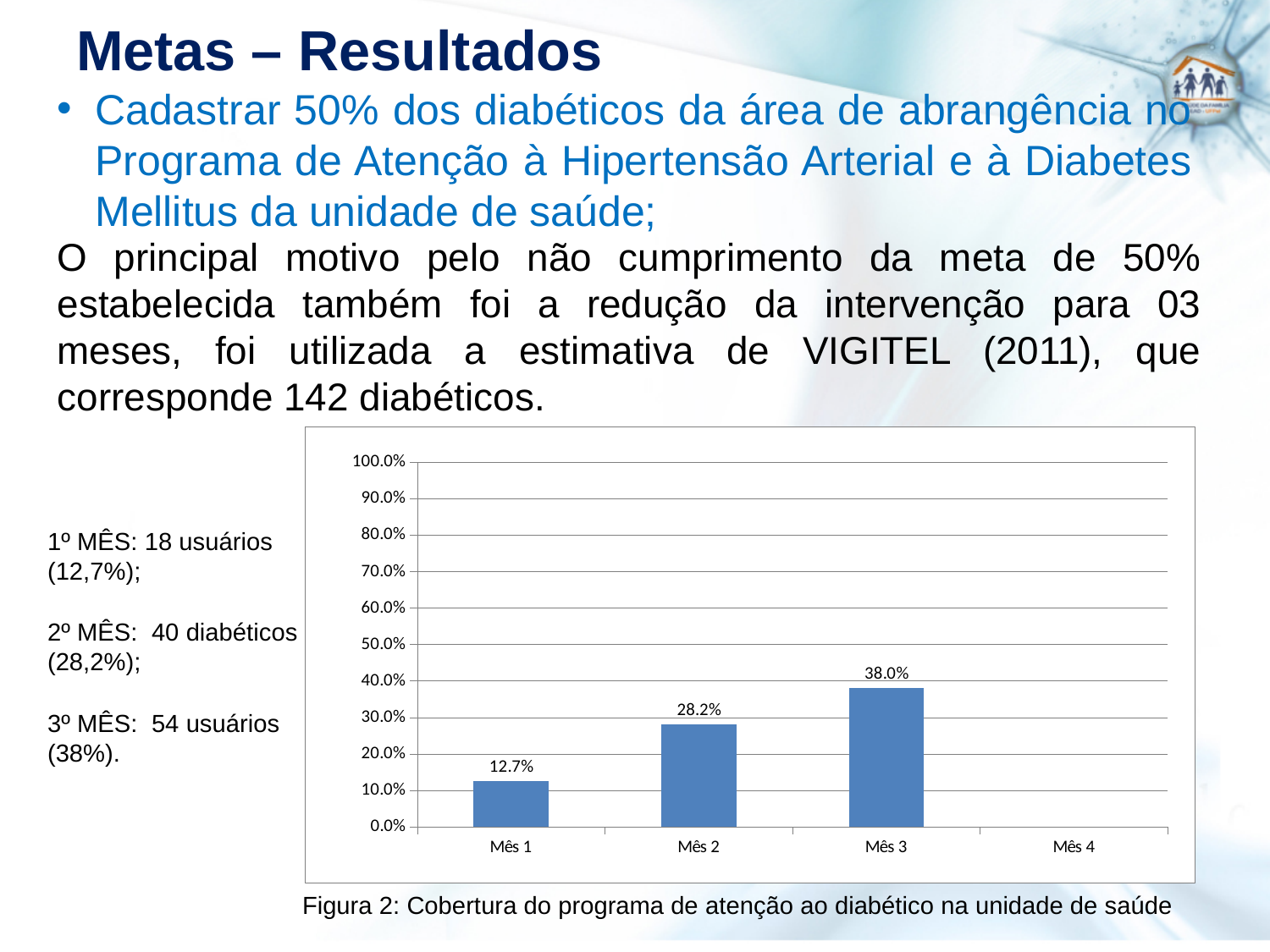
What is the value for Mês 1? 12.7% How many categories are shown on the x axis? 4 What is the value for Mês 2? 28.2% Which month has the highest value? Mês 3 What is the difference between the values for Mês 2 and Mês 1? 15.5% Which is larger, the value for Mês 2 or the value for Mês 3? Mês 3 What kind of chart is shown? bar chart Is the value for Mês 3 greater or less than 50.0%? less What is the value for Mês 3? 38.0% What is the difference between the values for Mês 3 and Mês 1? 25.3% Which month with a plotted bar has the lowest value? Mês 1 Do the values rise or fall from Mês 1 to Mês 3? rise